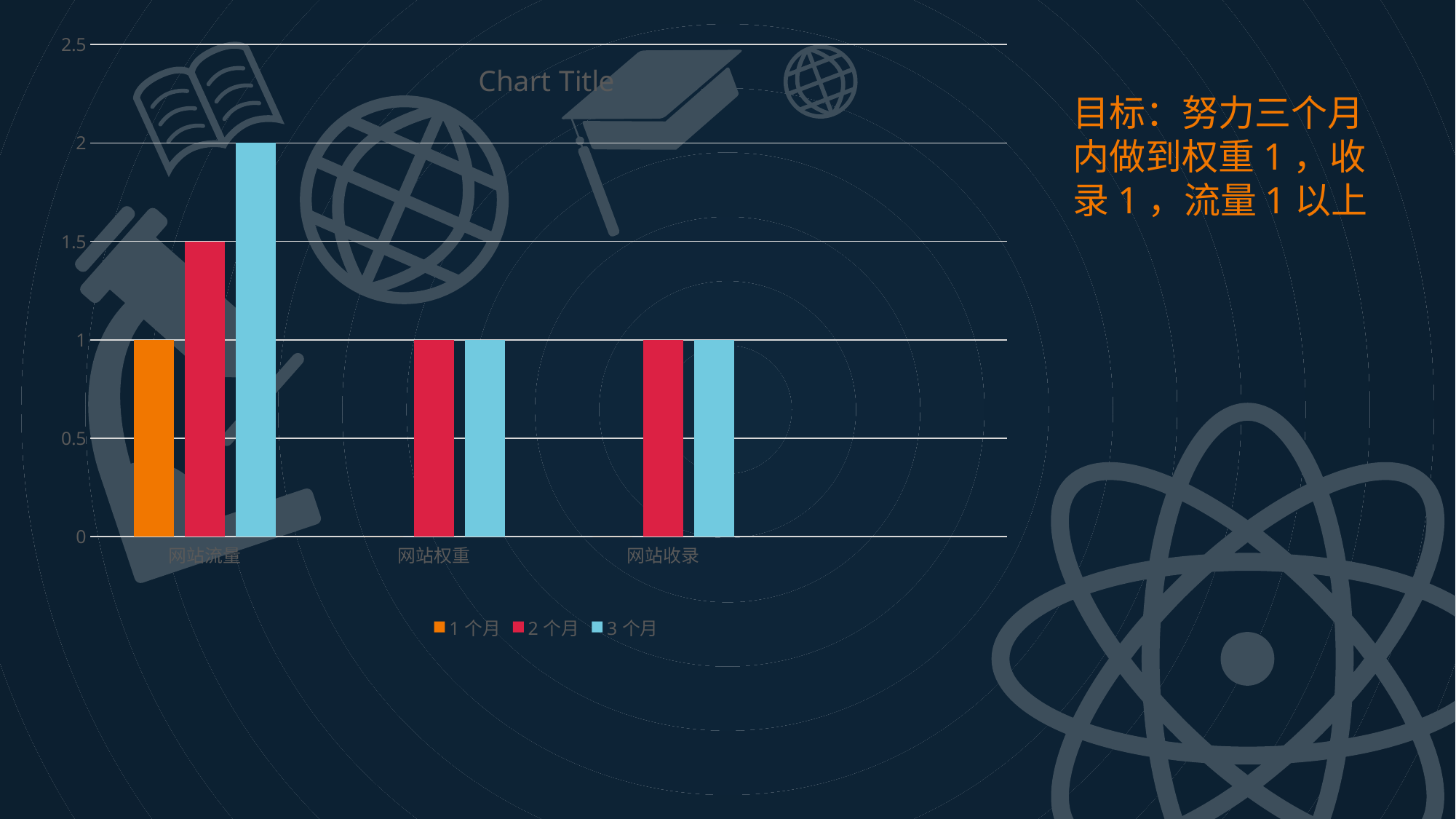
How many categories are shown on the x axis of the chart? 3 What is the value of the 2 个月 series for 网站流量? 1.5 Which category has the highest value in the 3 个月 series? 网站流量 Do the values for 网站流量 rise or fall from the 1 个月 series to the 3 个月 series? rise How many series does the chart legend list? 3 What is the value of the 1 个月 series for 网站流量? 1 Which is larger for 网站流量: the 2 个月 value or the 1 个月 value? 2 个月 What is the difference between the 3 个月 and 1 个月 values for 网站流量? 1 What is the title of the chart? Chart Title What is the value of the 3 个月 series for 网站权重? 1 What is the value of the 3 个月 series for 网站流量? 2 What kind of chart is shown on the slide? bar chart